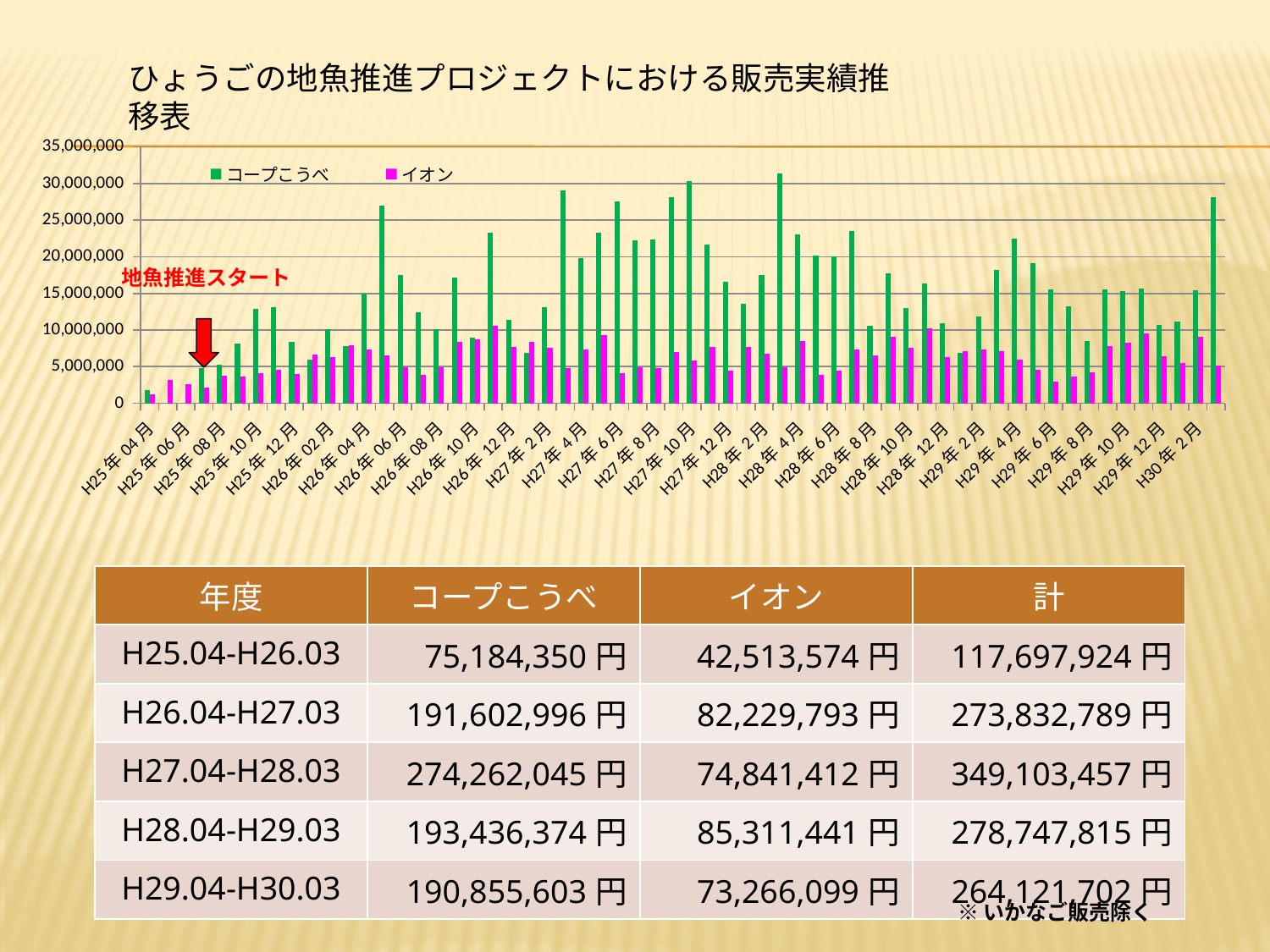
Is the コープこうべ value for H30年2月 greater or less than 25,000,000? less Is the コープこうべ value for H27年10月 greater or less than 25,000,000? greater Is the イオン value for H27年6月 greater or less than 10,000,000? less How many series does the chart legend list? 2 Which is larger, the コープこうべ value for H27年10月 or for H25年10月? H27年10月 Which two series are listed in the chart legend? コープこうべ and イオン What is the red annotation text placed above the arrow on the chart? 地魚推進スタート What kind of chart is shown on the slide? bar chart Do the コープこうべ values generally rise or fall from H25年04月 to H26年06月? rise